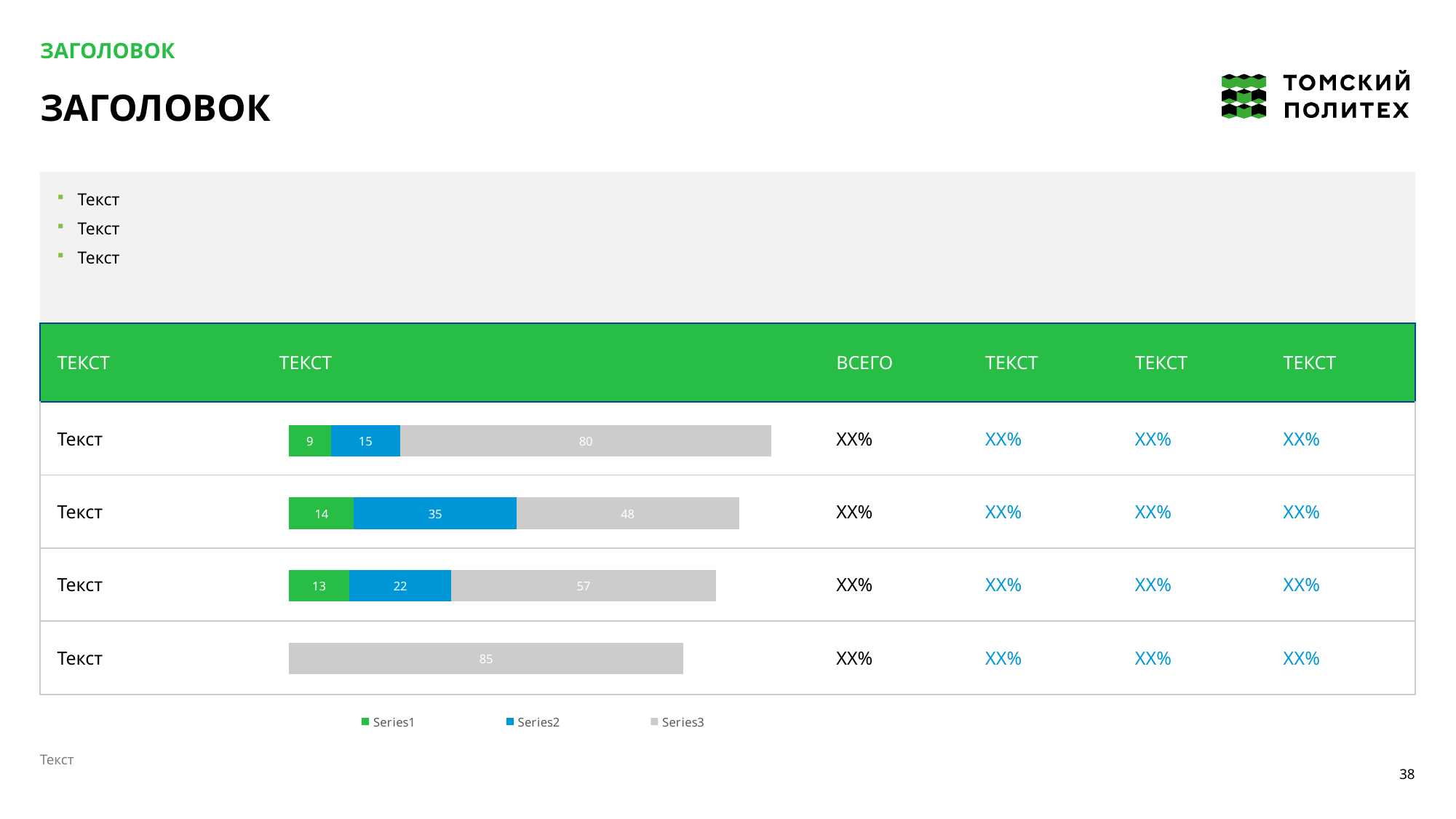
What is the Series1 value in the third row of the chart? 13 What is the total of the stacked bar in the first row? 104 What kind of chart is shown inside the table on the slide? Stacked bar chart What is the Series3 value in the first row of the chart? 80 How many series does the chart legend list? 3 What is the Series2 value in the second row of the chart? 35 What is the value shown in the fourth (bottom) bar of the chart? 85 Which colour represents Series3 in the legend? Grey What is the difference between the Series3 values in the first and second rows? 32 Which row has the highest Series2 value? Second row (35) How many bars (rows) does the chart contain? 4